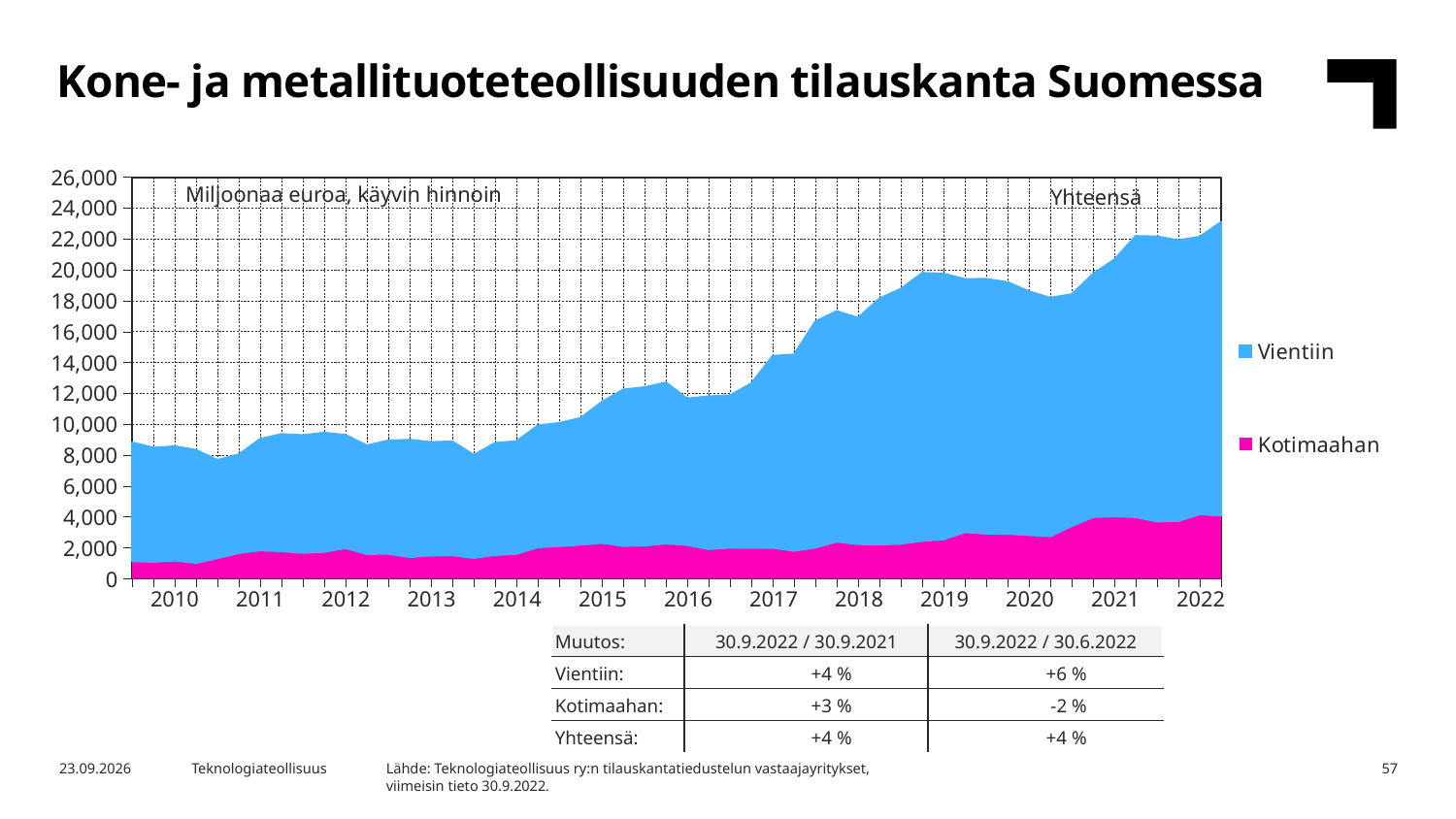
How many years are labelled on the x axis of the chart? 13 Is the Kotimaahan value at the end of 2022 greater or less than 2,000? greater Is the total (Yhteensä) value in 2015 greater or less than 10,000? greater Is the total (Yhteensä) value at the end of 2022 greater or less than 20,000? greater What unit is stated in the label at the top left of the chart? Miljoonaa euroa, käyvin hinnoin Which two series are listed in the chart legend? Vientiin and Kotimaahan Which series is larger throughout the chart, Vientiin or Kotimaahan? Vientiin What kind of chart is shown on the slide? Stacked area chart How many series does the chart legend list? 2 Does the total order book (Yhteensä) generally rise or fall from 2010 to 2022? rise